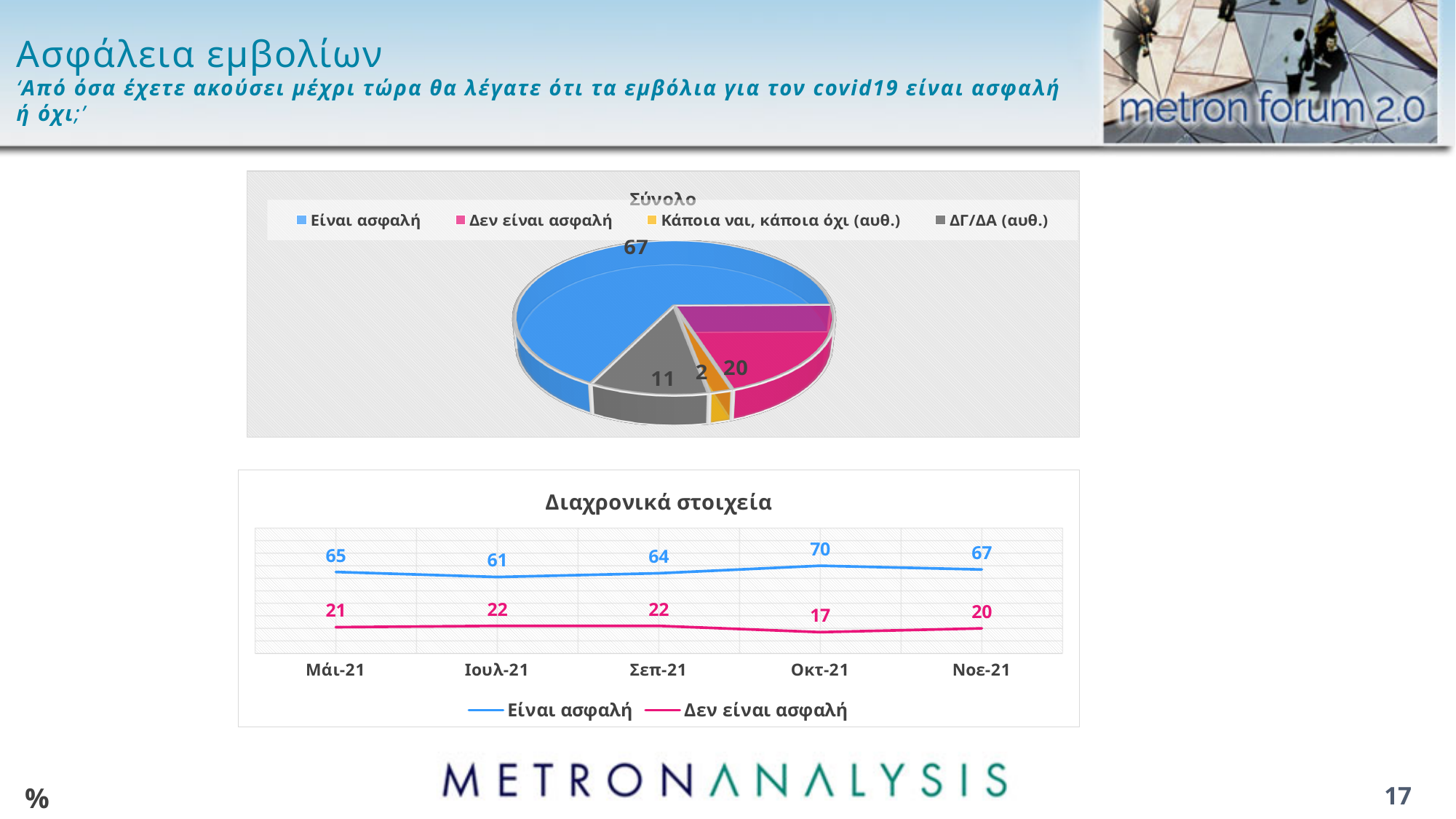
In the chart titled 'Διαχρονικά στοιχεία', what is the value for 'Δεν είναι ασφαλή' in Ιουλ-21? 22 In the pie chart titled 'Σύνολο', what is the value for 'Είναι ασφαλή'? 67 In the chart titled 'Διαχρονικά στοιχεία', how many time periods are shown on the x axis? 5 In the pie chart titled 'Σύνολο', how many categories does the legend list? 4 In the chart titled 'Διαχρονικά στοιχεία', in which period is 'Είναι ασφαλή' at its lowest? Ιουλ-21 In the chart titled 'Διαχρονικά στοιχεία', what is the value for 'Είναι ασφαλή' in Οκτ-21? 70 In the chart titled 'Διαχρονικά στοιχεία', how many series does the legend list? 2 In the pie chart titled 'Σύνολο', which category has the smallest slice? Κάποια ναι, κάποια όχι (αυθ.) In the pie chart titled 'Σύνολο', what is the difference between 'Είναι ασφαλή' and 'Δεν είναι ασφαλή'? 47 In the pie chart titled 'Σύνολο', what is the value for 'ΔΓ/ΔΑ (αυθ.)'? 11 What kind of chart is the chart titled 'Διαχρονικά στοιχεία'? Line chart In the chart titled 'Διαχρονικά στοιχεία', in which period is 'Δεν είναι ασφαλή' at its lowest? Οκτ-21